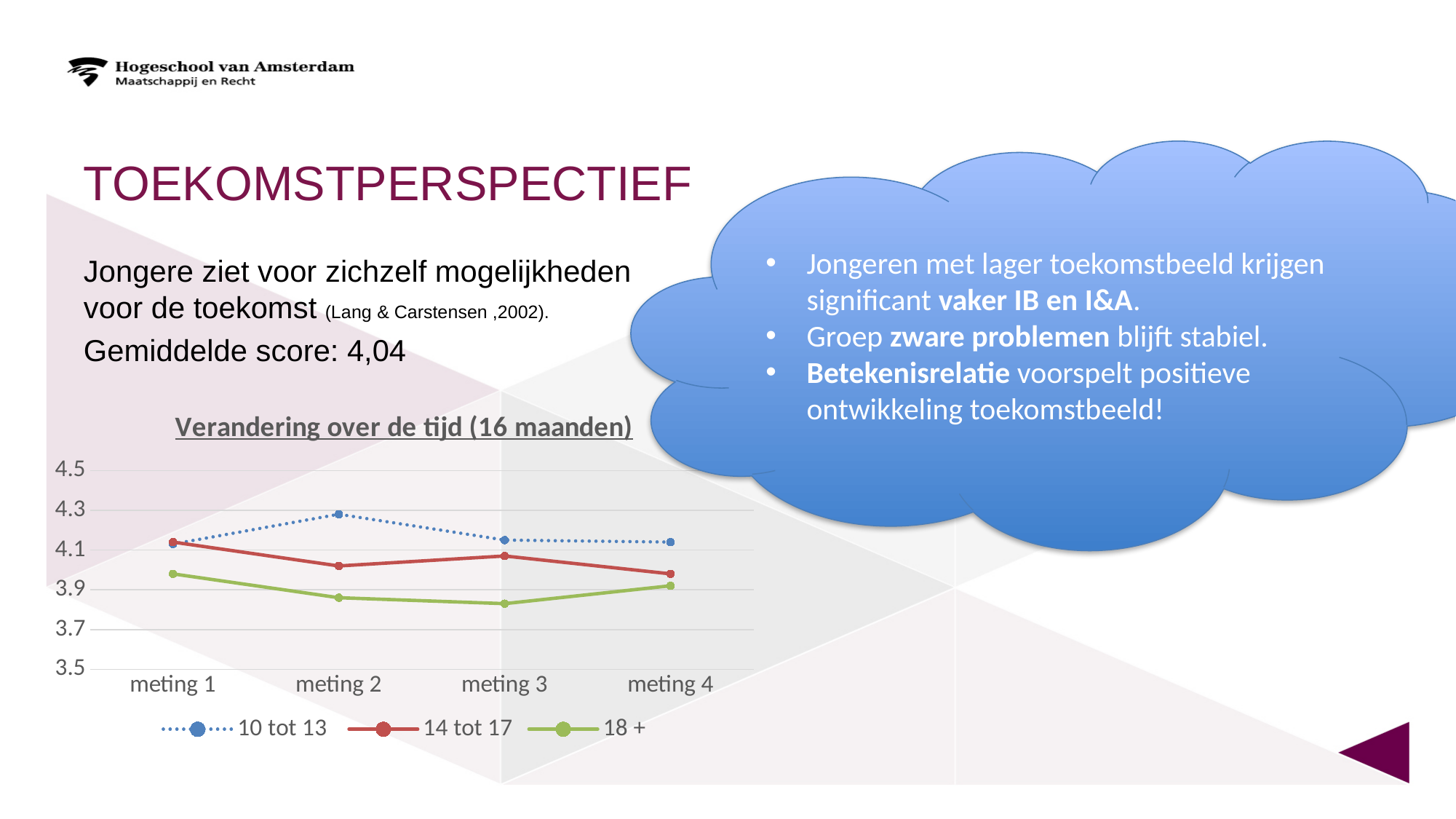
Is the value for 18 + at meting 3 greater or less than 3.9? less Is the value for 10 tot 13 at meting 2 greater or less than 4.1? greater Which series has the lowest value at meting 3? 18 + What kind of chart is shown on the slide? line chart At meting 4, which is larger: the value for 14 tot 17 or the value for 18 +? 14 tot 17 Which series is drawn with a dotted line? 10 tot 13 What is the title of the chart? Verandering over de tijd (16 maanden) How many measurement points (metingen) are shown on the x axis? 4 Which series has the highest value at meting 2? 10 tot 13 At which meting does the 10 tot 13 series reach its highest value? meting 2 Does the 18 + series rise or fall from meting 1 to meting 3? fall How many series does the chart legend list? 3